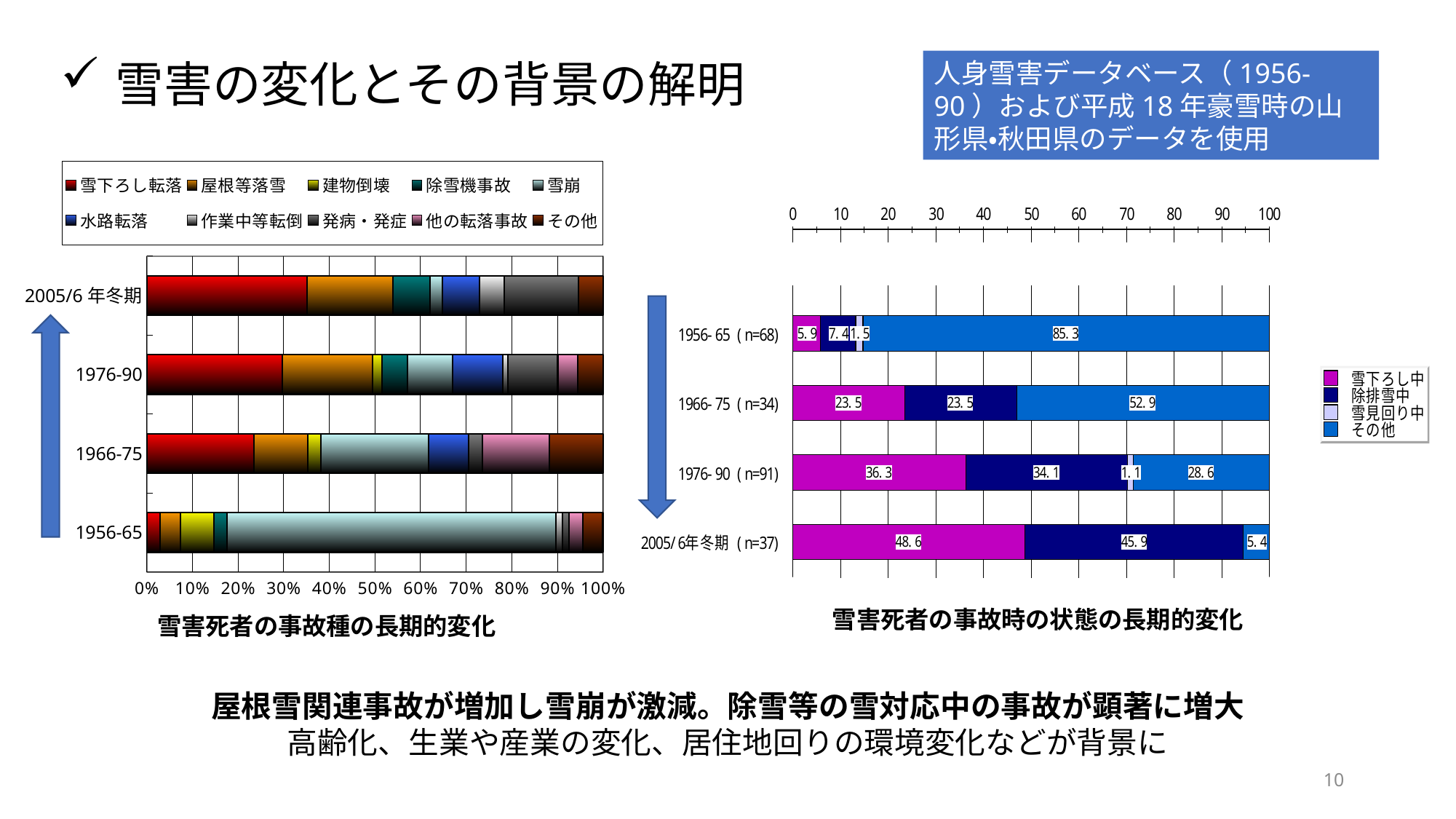
In the right chart (雪害死者の事故時の状態の長期的変化), which period has the lowest value for その他? 2005/6年冬期 (n=37) In the right chart (雪害死者の事故時の状態の長期的変化), what is the value for その他 in 1956-65 (n=68)? 85.3 In the right chart (雪害死者の事故時の状態の長期的変化), which period has the highest value for 雪下ろし中? 2005/6年冬期 (n=37) In the right chart (雪害死者の事故時の状態の長期的変化), which is larger in 1966-75 (n=34): 雪下ろし中 or その他? その他 How many series does the legend of the left chart (雪害死者の事故種の長期的変化) list? 10 In the right chart (雪害死者の事故時の状態の長期的変化), what is the value for 除排雪中 in 1976-90 (n=91)? 34.1 In the right chart (雪害死者の事故時の状態の長期的変化), what is the value for 雪下ろし中 in 2005/6年冬期 (n=37)? 48.6 In the right chart (雪害死者の事故時の状態の長期的変化), does the その他 value rise or fall from 1956-65 to 2005/6年冬期? fall How many periods (categories) are plotted in the left chart (雪害死者の事故種の長期的変化)? 4 What kind of chart is the left chart (雪害死者の事故種の長期的変化)? stacked bar chart In the right chart (雪害死者の事故時の状態の長期的変化), what is the difference between the 雪下ろし中 value and the 除排雪中 value in 2005/6年冬期 (n=37)? 2.7 How many series does the legend of the right chart (雪害死者の事故時の状態の長期的変化) list? 4